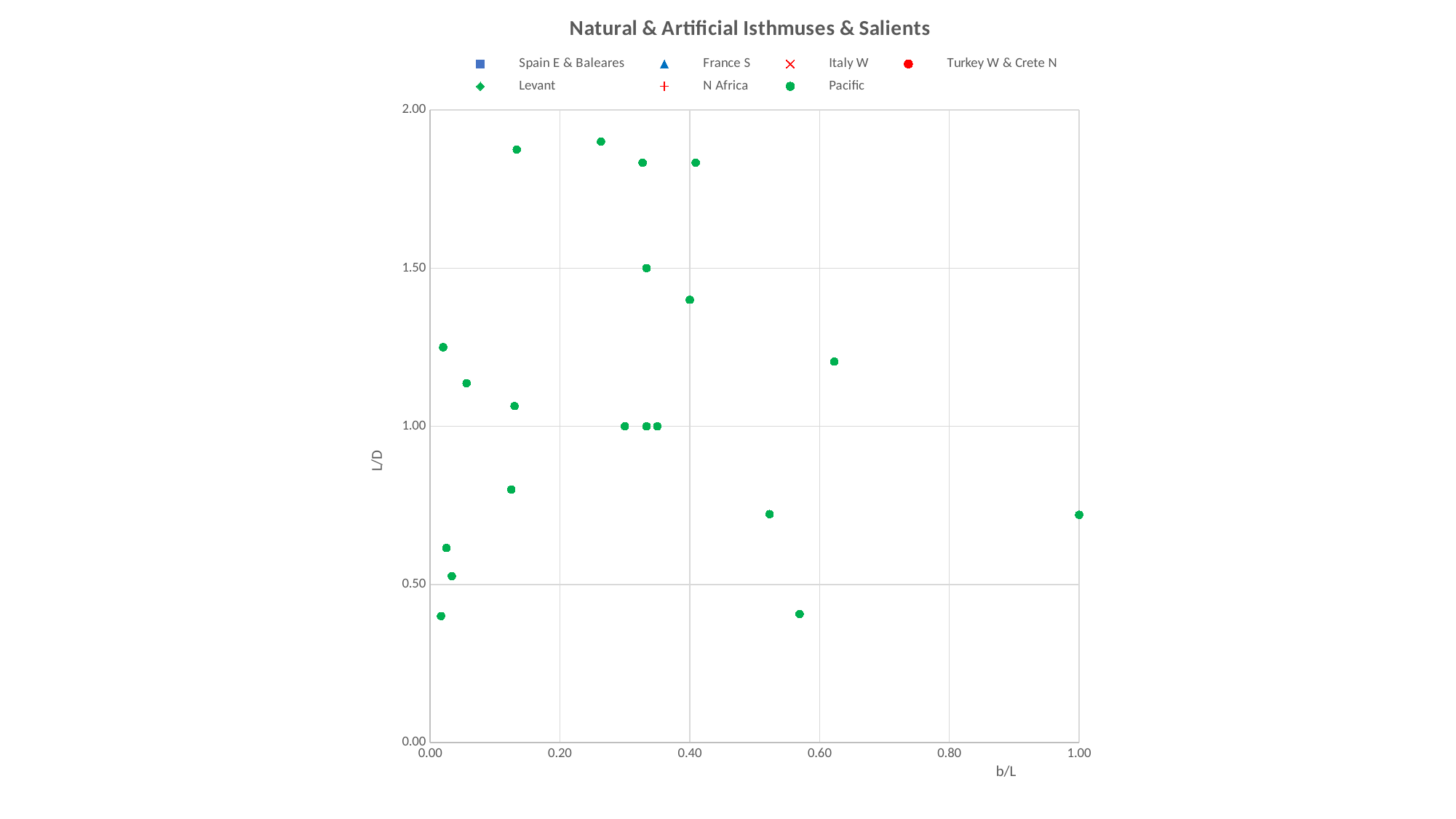
Is the L/D value for the point at about b/L = 0.26 greater or less than 1.50? greater What is the title of the chart? Natural & Artificial Isthmuses & Salients What is the highest value shown on the vertical (L/D) axis? 2.00 Is the L/D value for the point at about b/L = 0.52 greater or less than 1.00? less How many series does the legend list? 7 Is the L/D value for the point at about b/L = 0.57 greater or less than 0.50? less What is the label of the horizontal axis? b/L Which of the two points, the one at about b/L = 0.62 or the one at about b/L = 0.52, has the higher L/D value? The one at about b/L = 0.62 What kind of chart is shown on the slide? Scatter chart